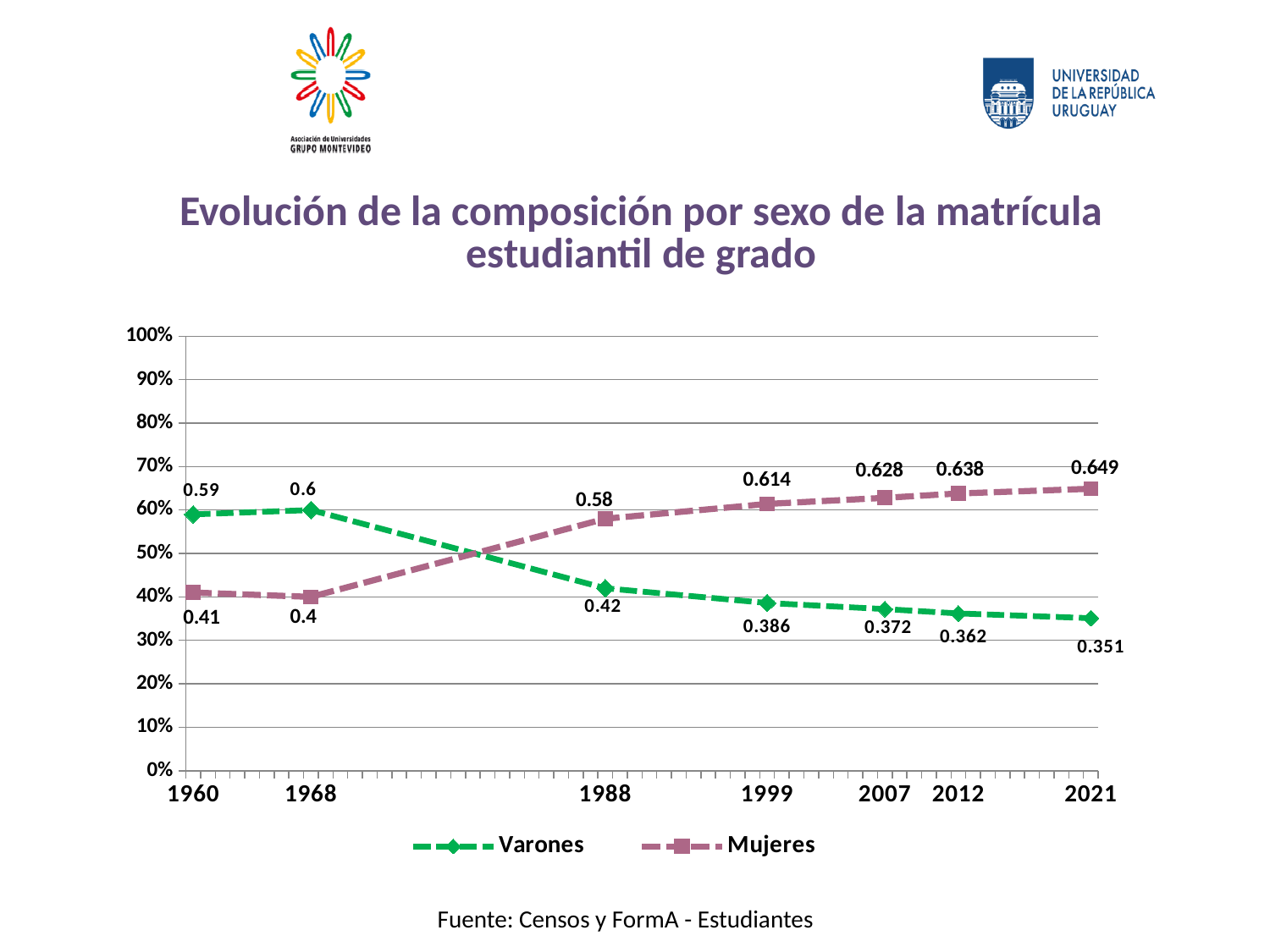
What is the value for Varones in 1960? 0.59 In which year is the Mujeres series at its highest? 2021 In which year is the Varones series at its lowest? 2021 What is the value for Varones in 1988? 0.42 How many series does the legend list? 2 In 1968, which series has the larger value, Varones or Mujeres? Varones How many years are plotted on the x axis? 7 What is the difference between the Mujeres and Varones values in 2007? 0.256 What is the value for Mujeres in 2021? 0.649 What is the value for Mujeres in 1999? 0.614 What kind of chart is shown on the slide? Line chart Is the value for Mujeres in 2012 greater or less than 50%? greater